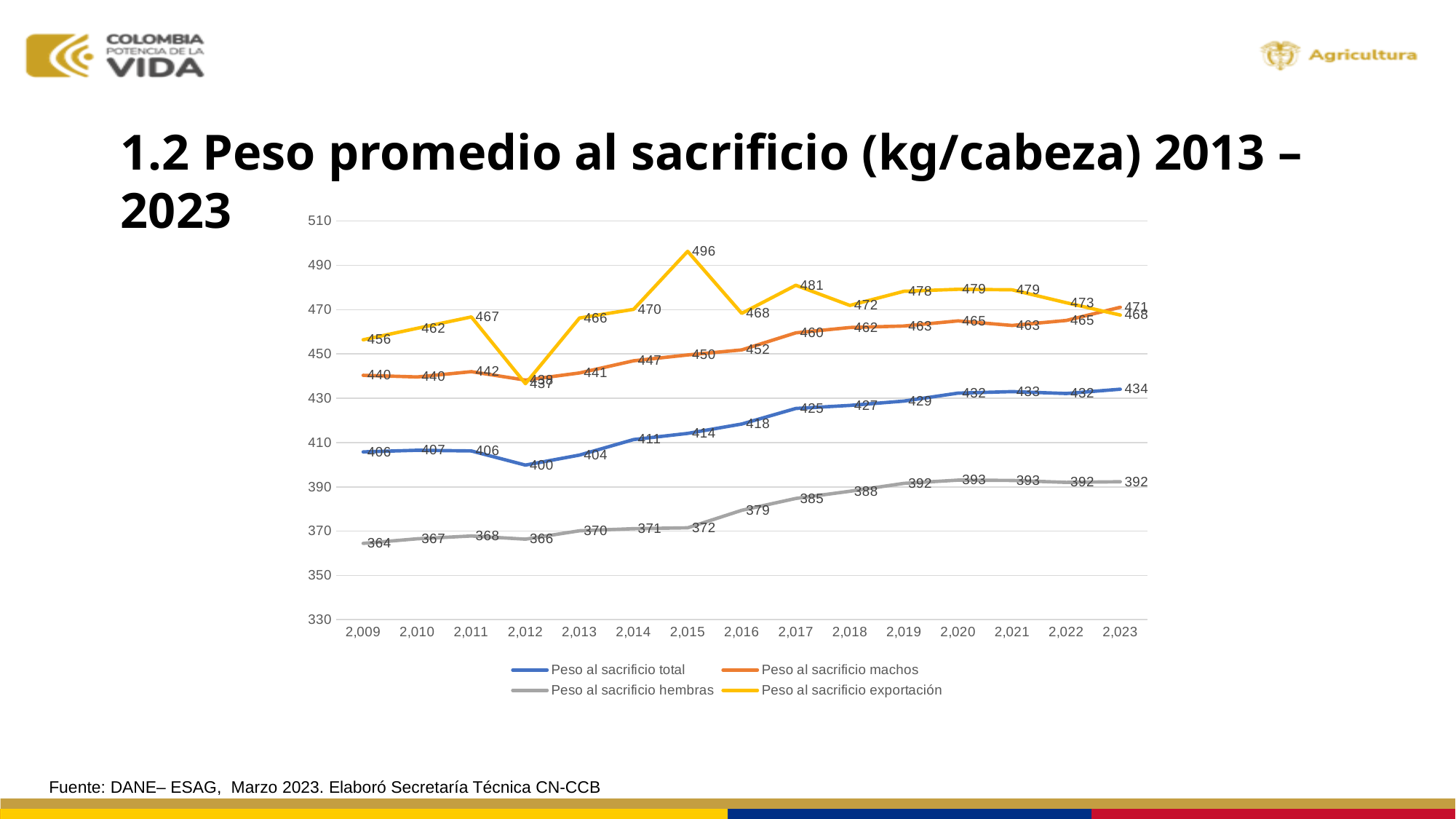
What is the value of Peso al sacrificio hembras in 2,009? 364 What colour is the line for Peso al sacrificio exportación? yellow In which year is Peso al sacrificio total at its lowest? 2,012 What is the value of Peso al sacrificio machos in 2,017? 460 How many years are plotted along the x axis? 15 What is the difference between Peso al sacrificio total in 2,023 and in 2,009? 28 In which year does Peso al sacrificio exportación reach its highest value? 2,015 What is the value of Peso al sacrificio exportación in 2,015? 496 In 2,023, which is larger: Peso al sacrificio machos or Peso al sacrificio exportación? Peso al sacrificio machos How many series does the legend list? 4 Does Peso al sacrificio hembras generally rise or fall from 2,009 to 2,023? rise What kind of chart is shown on the slide? line chart